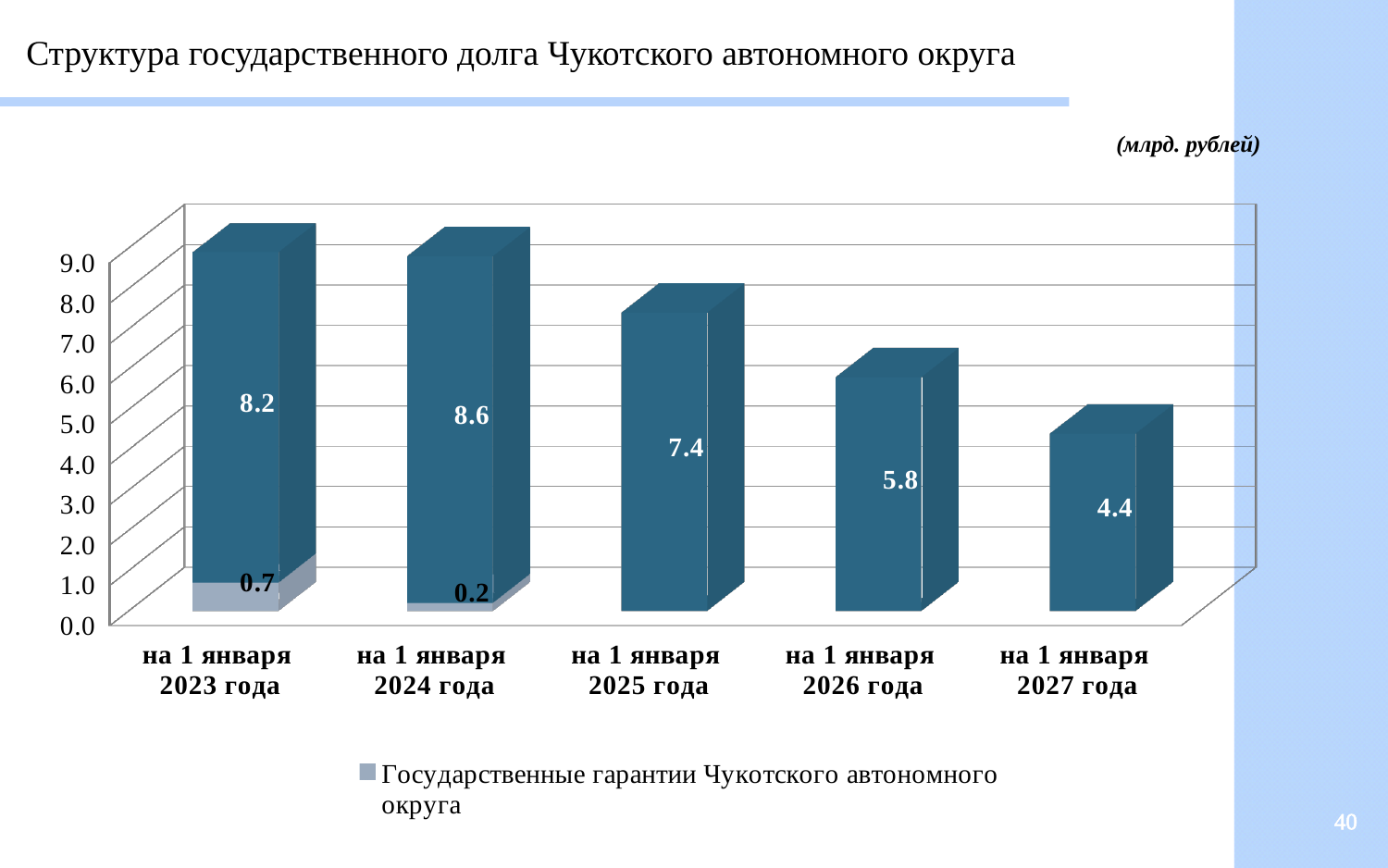
How many categories are shown on the x axis? 5 In what units are the values on the chart given? млрд. рублей What is the value of the dark blue segment for 'на 1 января 2027 года'? 4.4 What kind of chart is shown on the slide? Bar chart What is the difference between the dark blue segment values for 'на 1 января 2025 года' and 'на 1 января 2026 года'? 1.6 What is the value of the dark blue segment for 'на 1 января 2024 года'? 8.6 What is the total of the stacked bar for 'на 1 января 2023 года'? 8.9 What is the value of the grey 'Государственные гарантии Чукотского автономного округа' segment for 'на 1 января 2023 года'? 0.7 Which category has the highest value for the dark blue segment? на 1 января 2024 года How many series does the legend list? 1 Which category has the lowest value for the dark blue segment? на 1 января 2027 года Which is larger: the dark blue segment for 'на 1 января 2023 года' or for 'на 1 января 2025 года'? на 1 января 2023 года